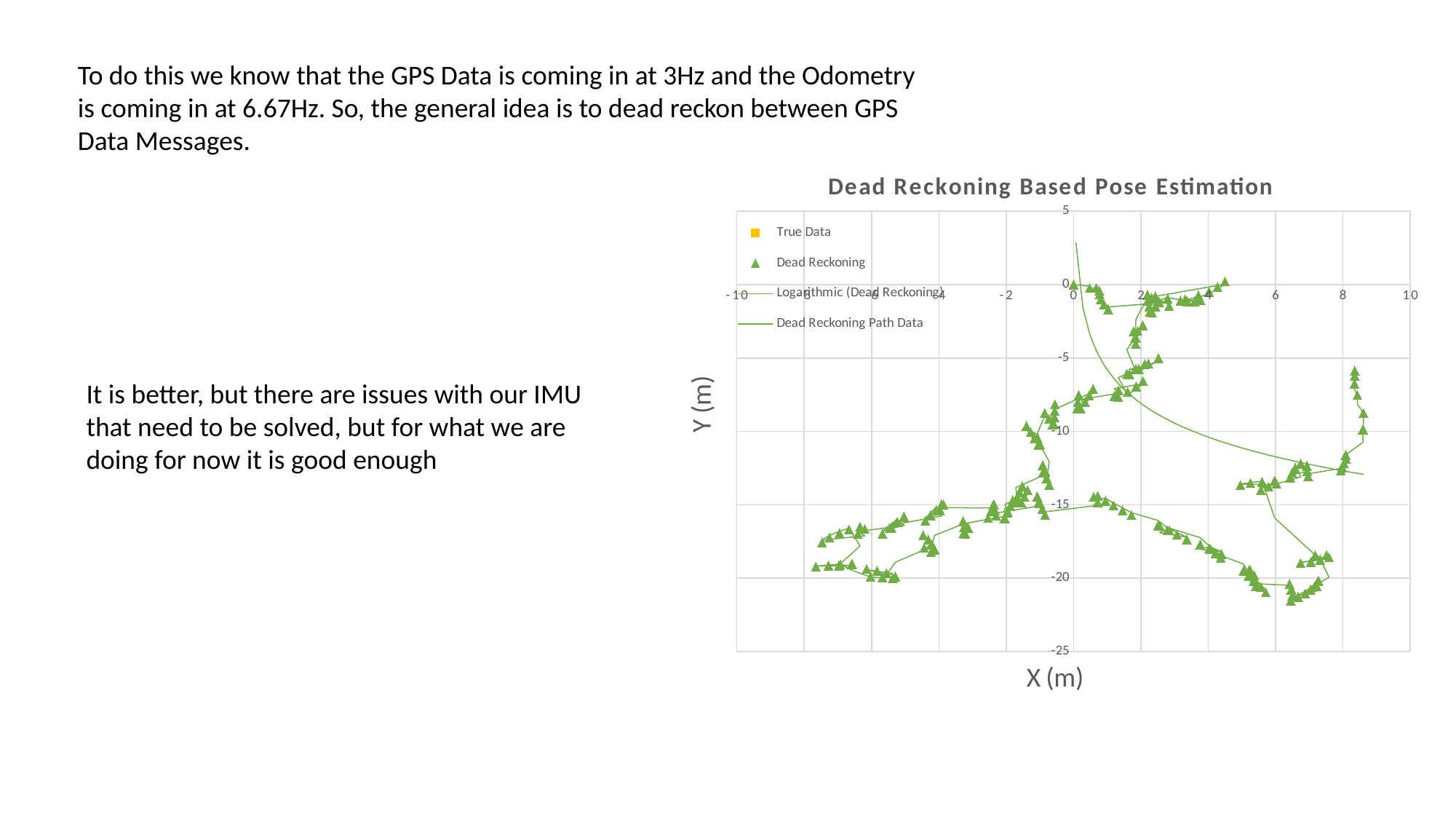
Do any of the Dead Reckoning points have a Y value less than -20? Yes How many entries does the chart's legend list? 4 Do any of the Dead Reckoning points have an X value less than -6? Yes Are all of the Dead Reckoning points plotted at Y values less than 5? Yes What kind of chart is shown on the slide? Scatter chart How many tick labels are shown on the chart's horizontal axis? 11 What is the title of the chart? Dead Reckoning Based Pose Estimation What is the label of the horizontal axis of the chart? X (m) How many tick labels are shown on the chart's vertical axis? 7